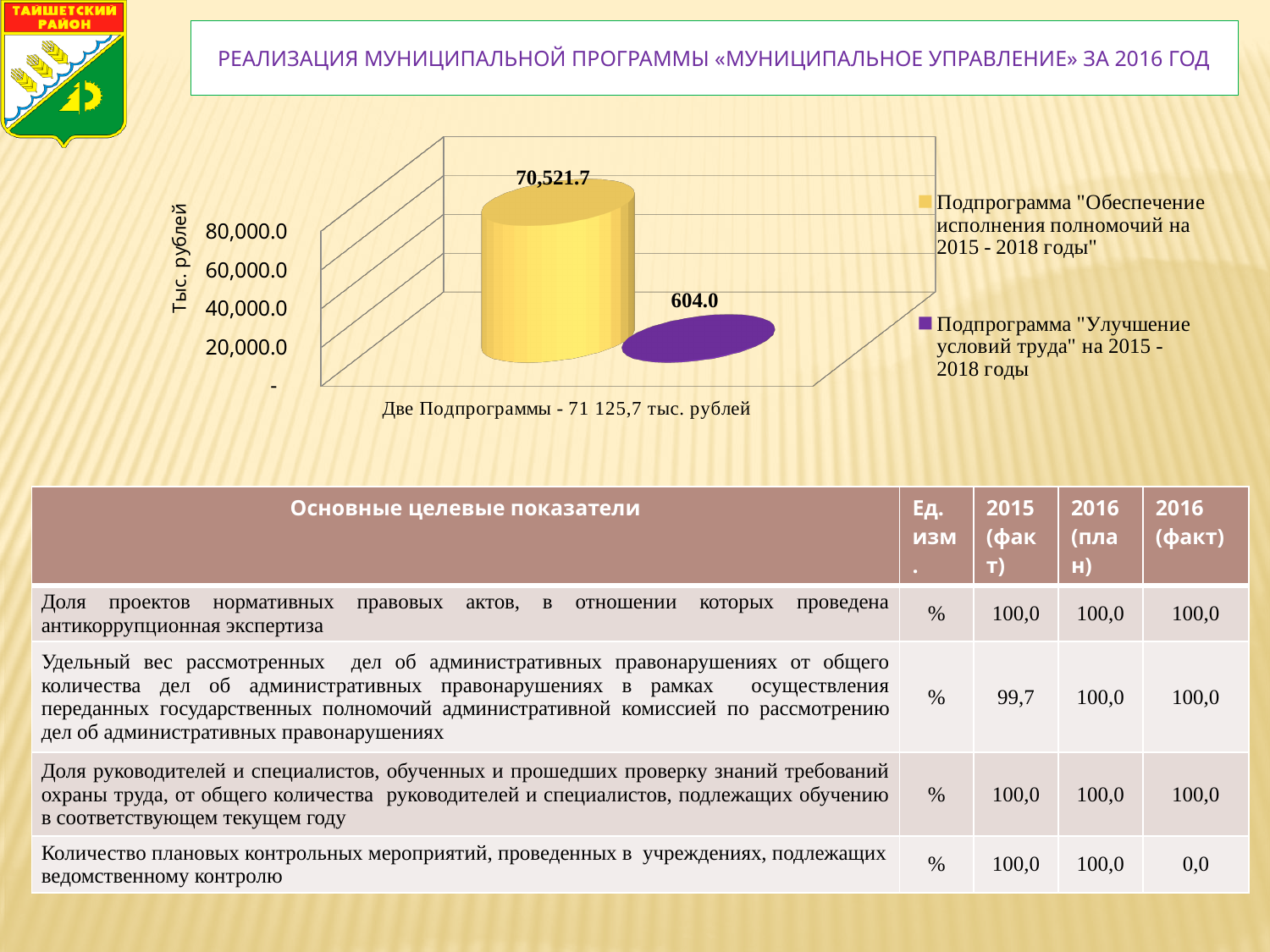
Is the value for the subprogramme "Улучшение условий труда" greater or less than 20,000.0? less What kind of chart is shown on the slide? bar chart Is the value for the subprogramme "Обеспечение исполнения полномочий" greater or less than 60,000.0? greater What is the value for the subprogramme "Улучшение условий труда" на 2015 - 2018 годы? 604.0 What is the value for the subprogramme "Обеспечение исполнения полномочий на 2015 - 2018 годы"? 70,521.7 What is the title of the vertical axis of the chart? Тыс. рублей Which subprogramme has the highest value on the chart? Подпрограмма "Обеспечение исполнения полномочий на 2015 - 2018 годы" What is the difference between the values of the two subprogrammes shown on the chart? 69,917.7 Which subprogramme has the lowest value on the chart? Подпрограмма "Улучшение условий труда" на 2015 - 2018 годы Which is larger: the value for "Обеспечение исполнения полномочий" or the value for "Улучшение условий труда"? Обеспечение исполнения полномочий According to the caption under the chart, what is the total for the two subprogrammes? 71 125,7 тыс. рублей How many series does the chart legend list? 2